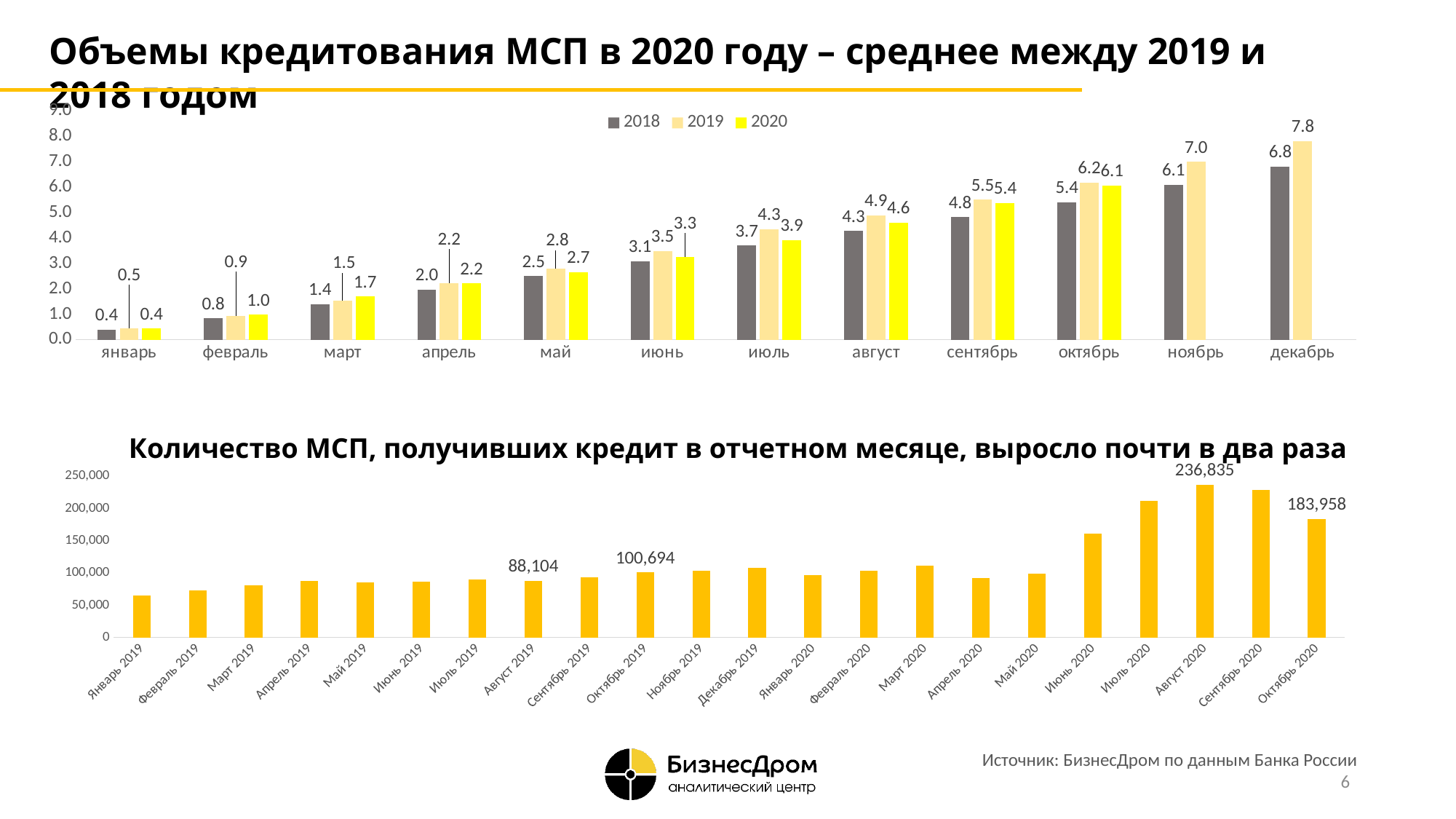
In the top chart, what is the value for 2019 in сентябрь (September)? 5.5 In the top chart, what is the value for 2020 in май (May)? 2.7 In the top chart, which month has the highest value for the 2019 series? декабрь In the bottom chart, what is the value for Октябрь 2019? 100,694 In the top chart, what is the difference between the 2019 and 2018 values in ноябрь (November)? 0.9 How many series does the legend of the top chart list? 3 In the top chart, what is the value for 2018 in декабрь (December)? 6.8 In the top chart, which is larger in июнь (June): the 2019 value or the 2020 value? 2019 In the bottom chart, is the value for Июль 2020 greater or less than 200,000? greater In the bottom chart, what is the value for Август 2020? 236,835 In the top chart, do the 2018 values rise or fall from январь to декабрь? rise What kind of chart is the bottom chart? bar chart